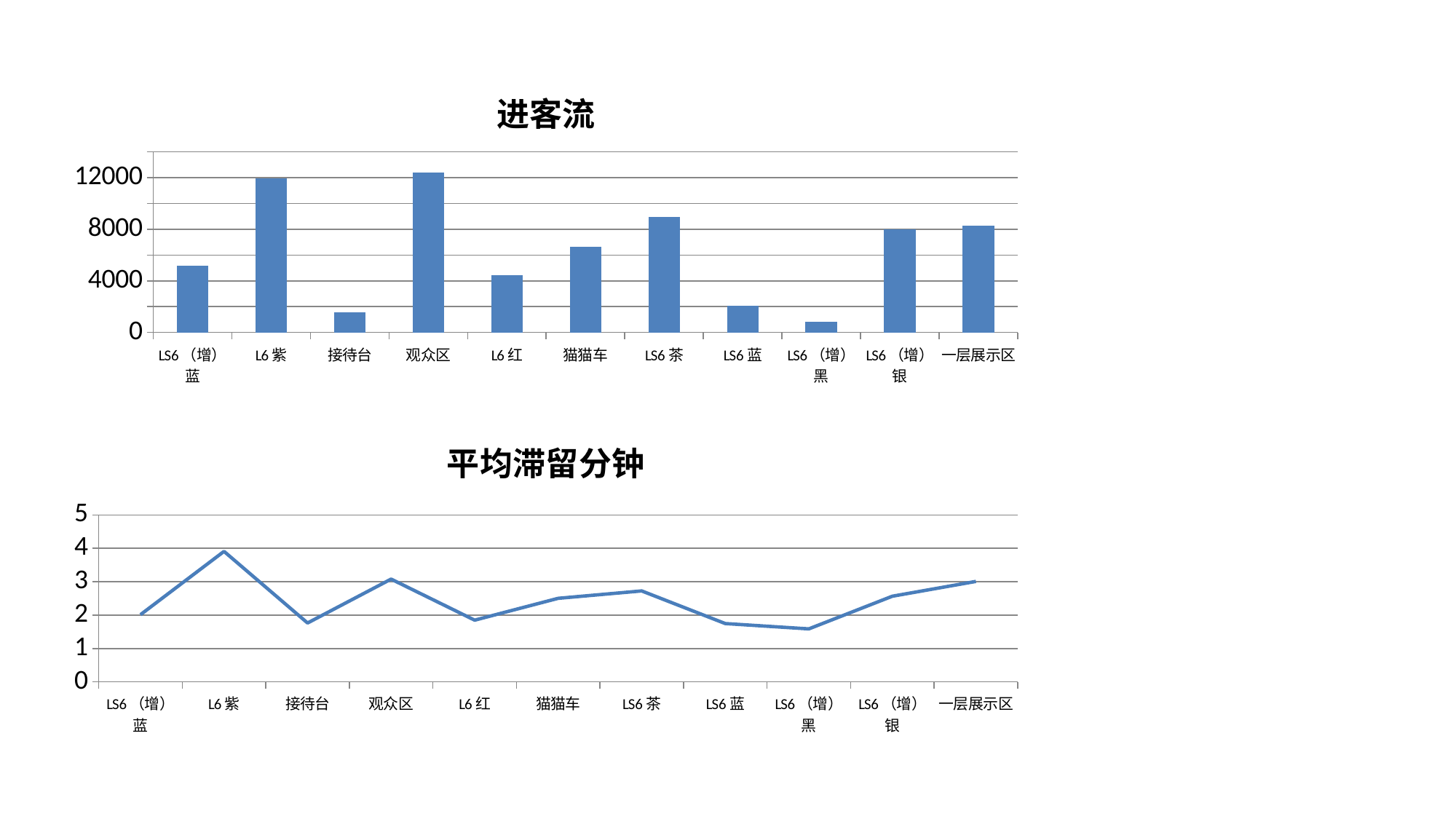
What type of chart is the bottom chart titled 平均滞留分钟? line chart In the 进客流 chart, which category has the lowest value? LS6（增）黑 In the 进客流 chart, which is larger, the value for LS6 茶 or the value for 猫猫车? LS6 茶 In the 进客流 chart, which category has the highest value? 观众区 In the 进客流 chart, is the value for LS6 茶 greater or less than 8000? greater What type of chart is the top chart titled 进客流? bar chart In the 平均滞留分钟 chart, which is larger, the value for 观众区 or the value for L6 红? 观众区 In the 平均滞留分钟 chart, is the value for L6 紫 greater or less than 3? greater In the 进客流 chart, is the value for 接待台 greater or less than 4000? less In the 进客流 chart, how many categories are shown on the x axis? 11 In the 平均滞留分钟 chart, which category has the highest value? L6 紫